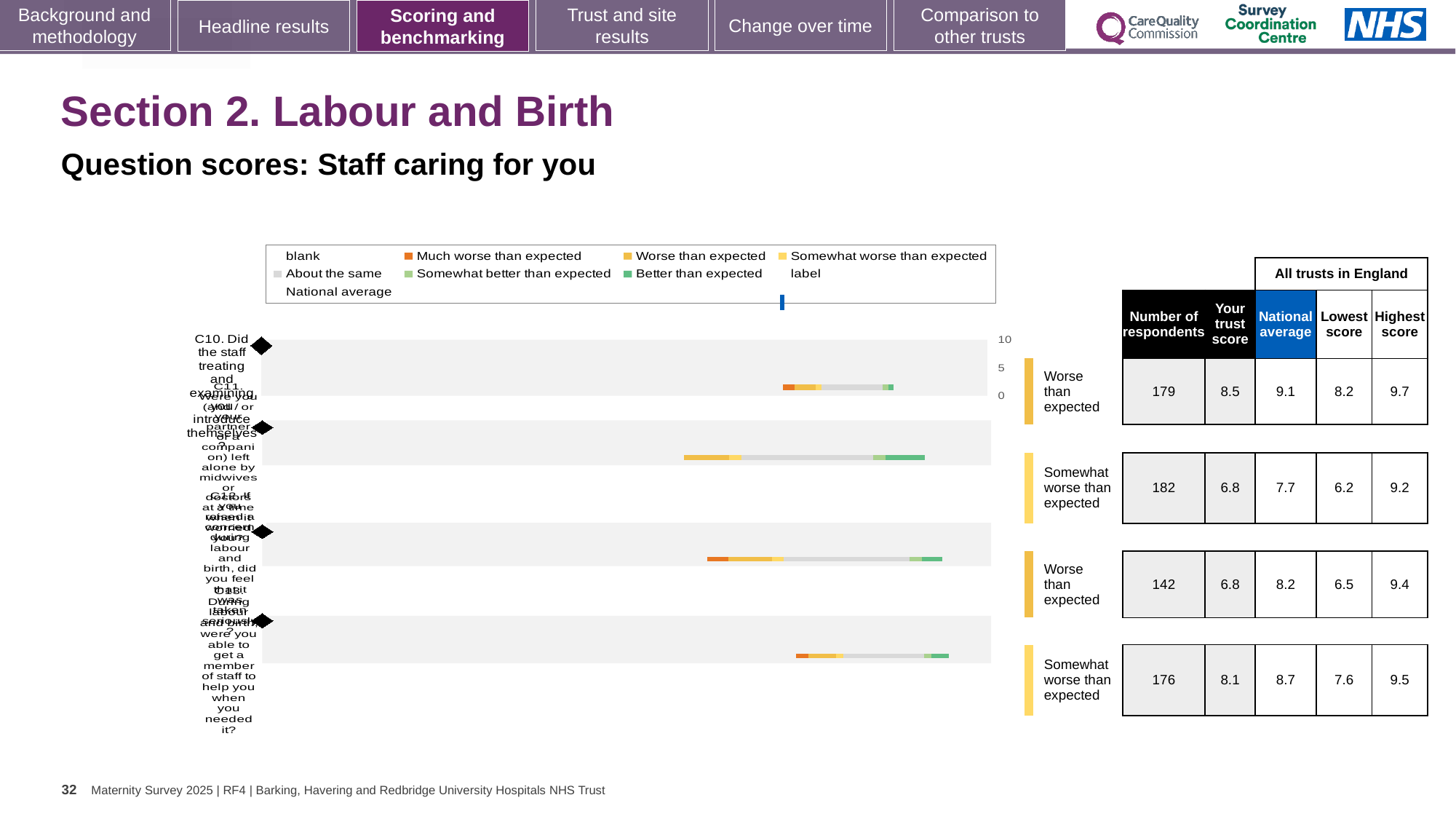
Which question row has the lowest number of respondents? the third row (142) Which question row has the highest number of respondents? the second row (182) What is the difference between the national average and the trust score for the first (top) question row, C10? 0.6 What is the highest score among all trusts in England for the fourth (bottom) question row? 9.5 What is the national average for the second question row? 7.7 What benchmark category is shown for the first (top) question row, C10? Worse than expected What is the number of respondents for the first (top) question row, C10? 179 Which is larger, the trust score for the first (top) row or the trust score for the fourth (bottom) row? the first row (8.5) What kind of chart is shown on the slide? bar chart What is the trust score for the first (top) question row, C10? 8.5 How many question rows are plotted in the chart? 4 What is the lowest score among all trusts in England for the third question row? 6.5